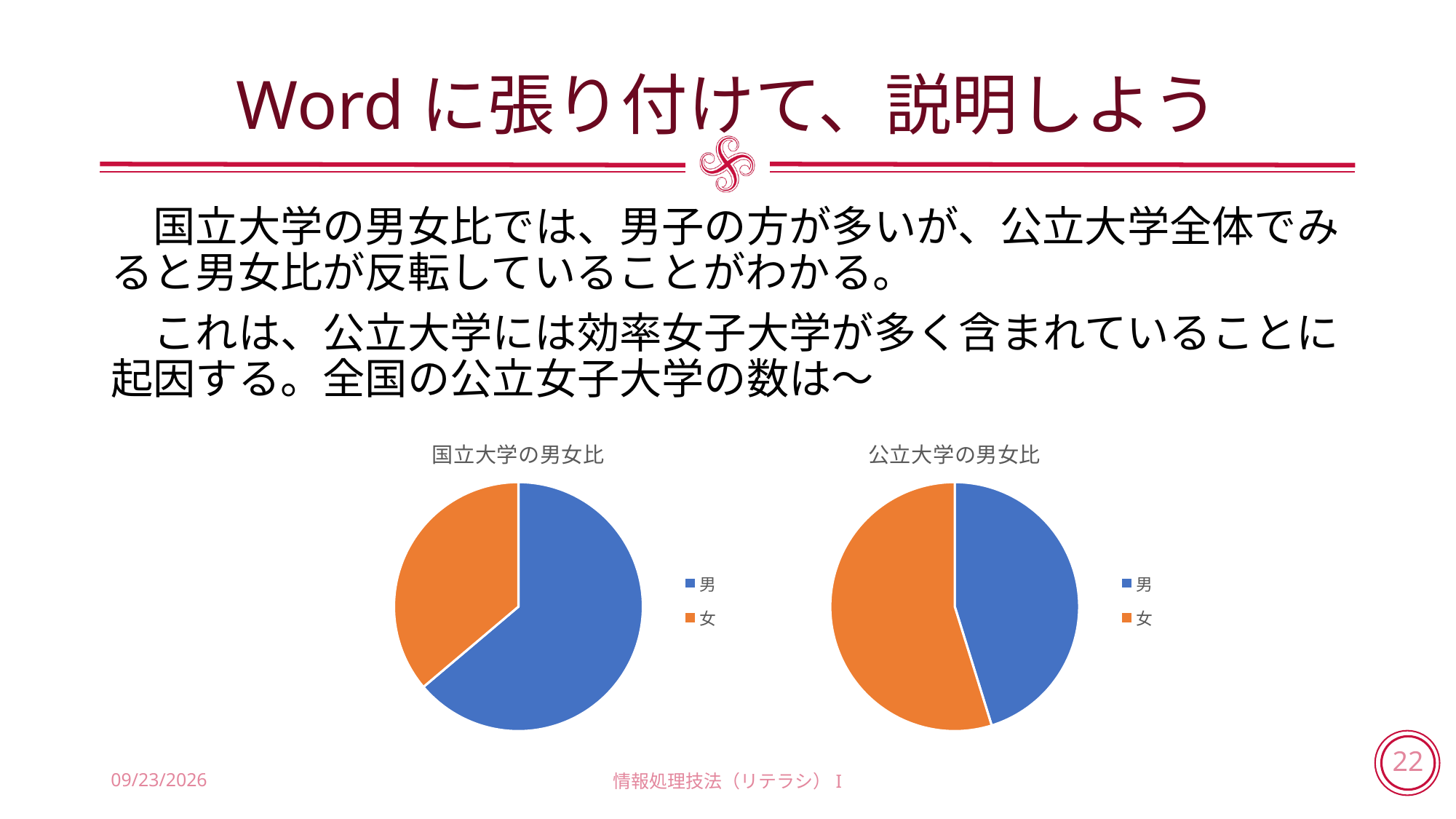
In the chart titled 公立大学の男女比, which category has the largest slice? 女 How many slices does the pie chart titled 国立大学の男女比 have? 2 What kind of chart is the chart titled 国立大学の男女比? pie chart In the chart titled 国立大学の男女比, which category has the smallest slice? 女 What kind of chart is the chart titled 公立大学の男女比? pie chart In the chart titled 国立大学の男女比, which category has the largest slice? 男 In the chart titled 国立大学の男女比, is the slice for 男 larger or smaller than the slice for 女? larger In the chart titled 公立大学の男女比, is the slice for 男 larger or smaller than the slice for 女? smaller How many entries does the legend of the chart titled 公立大学の男女比 list? 2 What is the title of the pie chart on the left of the slide? 国立大学の男女比 In the chart titled 公立大学の男女比, what colour is the slice for 女? orange In the chart titled 公立大学の男女比, which category has the smallest slice? 男